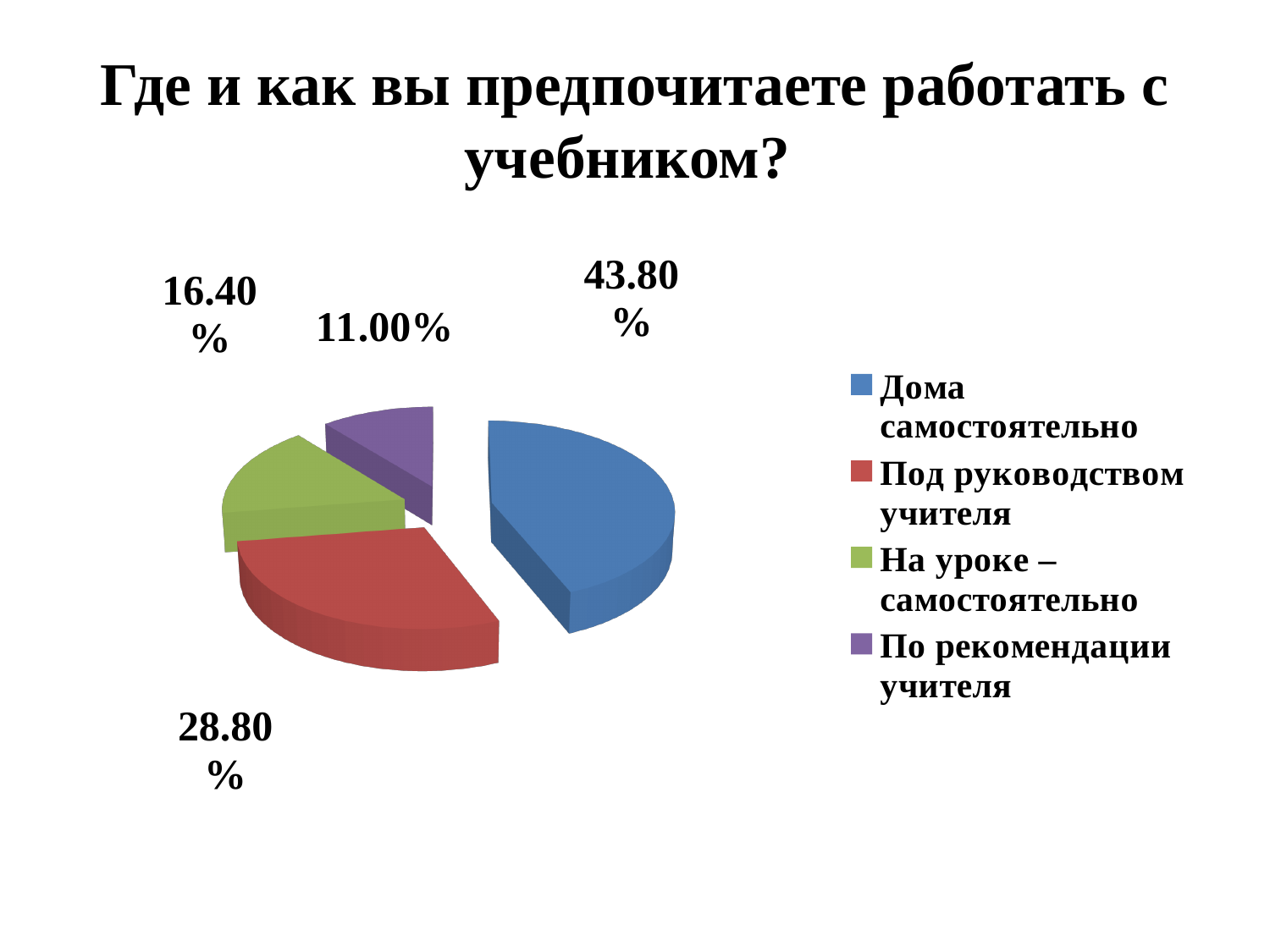
What is the difference between the values for "Дома самостоятельно" and "Под руководством учителя"? 15.00% Which category has the largest share of the pie? Дома самостоятельно What is the value for "По рекомендации учителя"? 11.00% What kind of chart is shown on the slide? pie chart How many categories does the pie chart have? 4 What is the title of the slide? Где и как вы предпочитаете работать с учебником? What is the value for "На уроке – самостоятельно"? 16.40% What colour is the slice for "Под руководством учителя"? red What is the value for "Под руководством учителя"? 28.80% What is the value for "Дома самостоятельно"? 43.80% Which is larger: "На уроке – самостоятельно" or "По рекомендации учителя"? На уроке – самостоятельно Which category has the smallest share of the pie? По рекомендации учителя